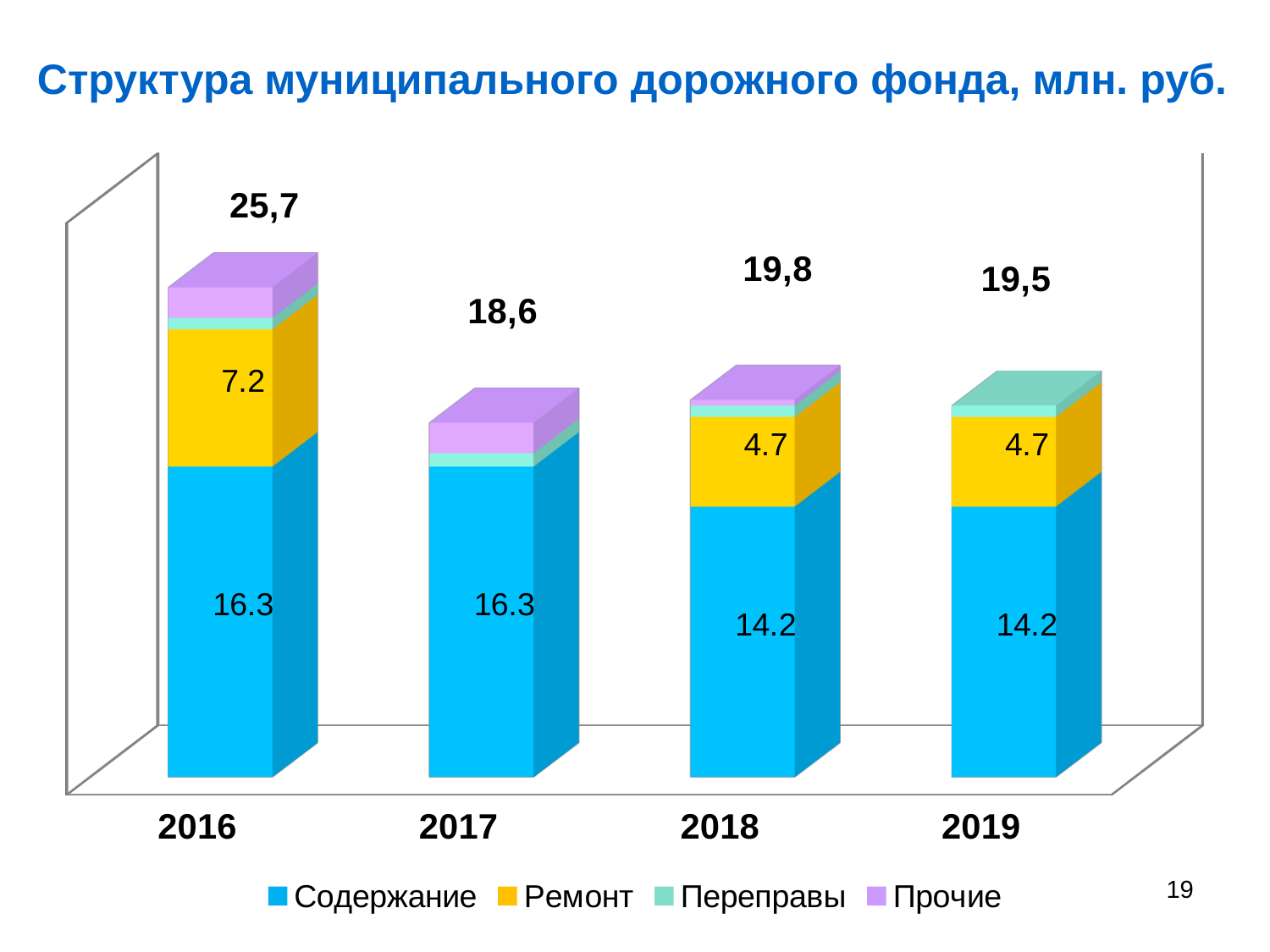
How many years are shown on the x axis? 4 Which is larger, the Содержание value for 2017 or for 2019? 2017 How many series does the legend list? 4 What is the value of the Содержание segment for 2018? 14.2 What is the difference between the totals for 2016 and 2017? 7,1 What is the difference between the Ремонт values for 2016 and 2018? 2.5 What is the value of the Ремонт segment for 2016? 7.2 What kind of chart is shown on the slide? Stacked bar chart What is the total value shown above the 2019 bar? 19,5 Which year has the highest total? 2016 What is the total value shown above the 2016 bar? 25,7 Which year has the lowest total? 2017